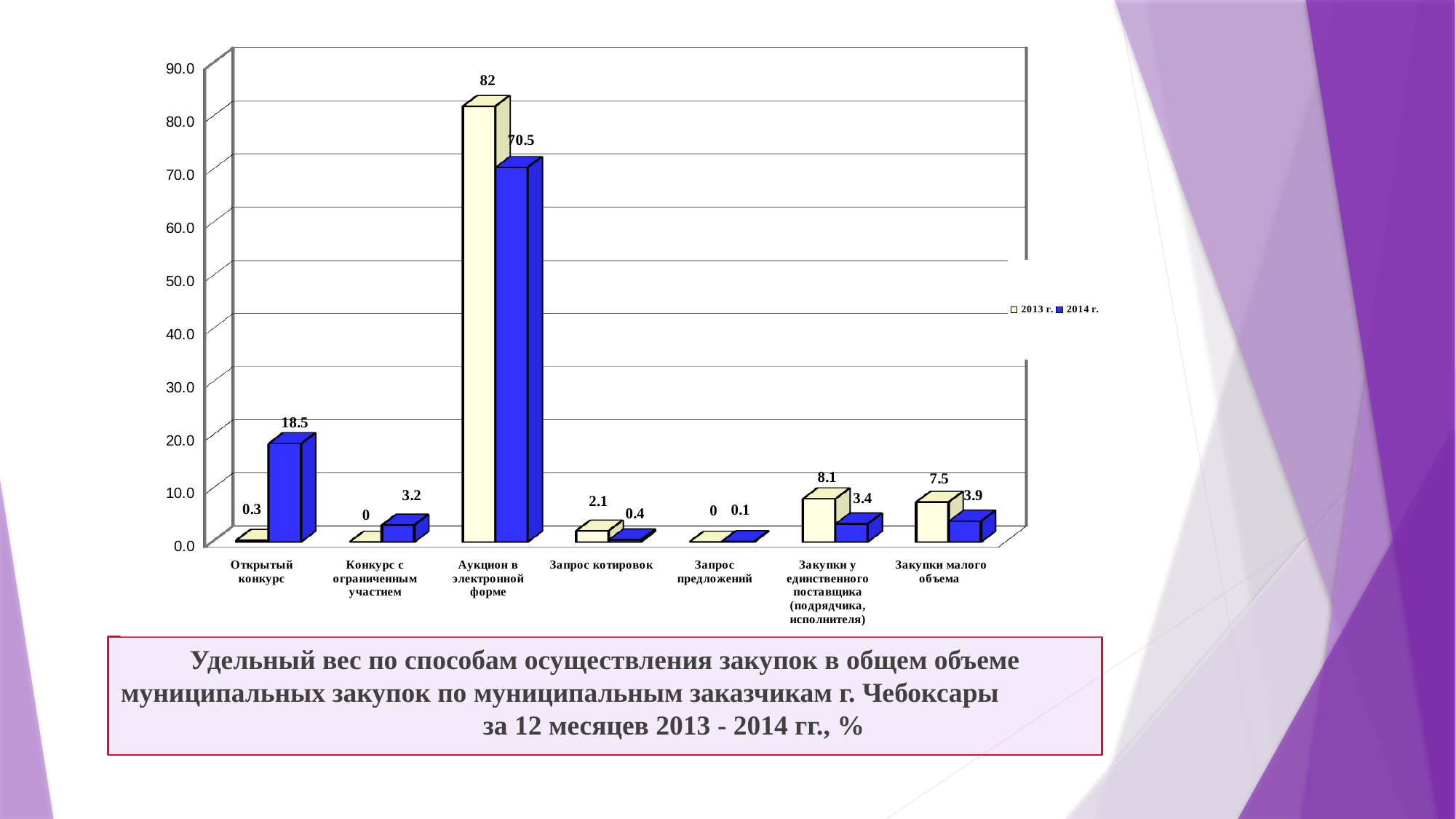
What kind of chart is shown on the slide? Bar chart Which category has the lowest value in the 2014 г. series? Запрос предложений What is the value for Закупки у единственного поставщика (подрядчика, исполнителя) in the 2013 г. series? 8.1 What is the difference between the 2013 г. and 2014 г. values for Аукцион в электронной форме? 11.5 Which is larger for Закупки малого объема: the 2013 г. value or the 2014 г. value? 2013 г. What is the value for Запрос котировок in the 2014 г. series? 0.4 What is the value for Аукцион в электронной форме in the 2013 г. series? 82 Which category has the highest value in the 2014 г. series? Аукцион в электронной форме Which colour represents the 2014 г. series? Blue What is the value for Открытый конкурс in the 2014 г. series? 18.5 How many series does the legend list? 2 How many categories are shown on the x axis? 7